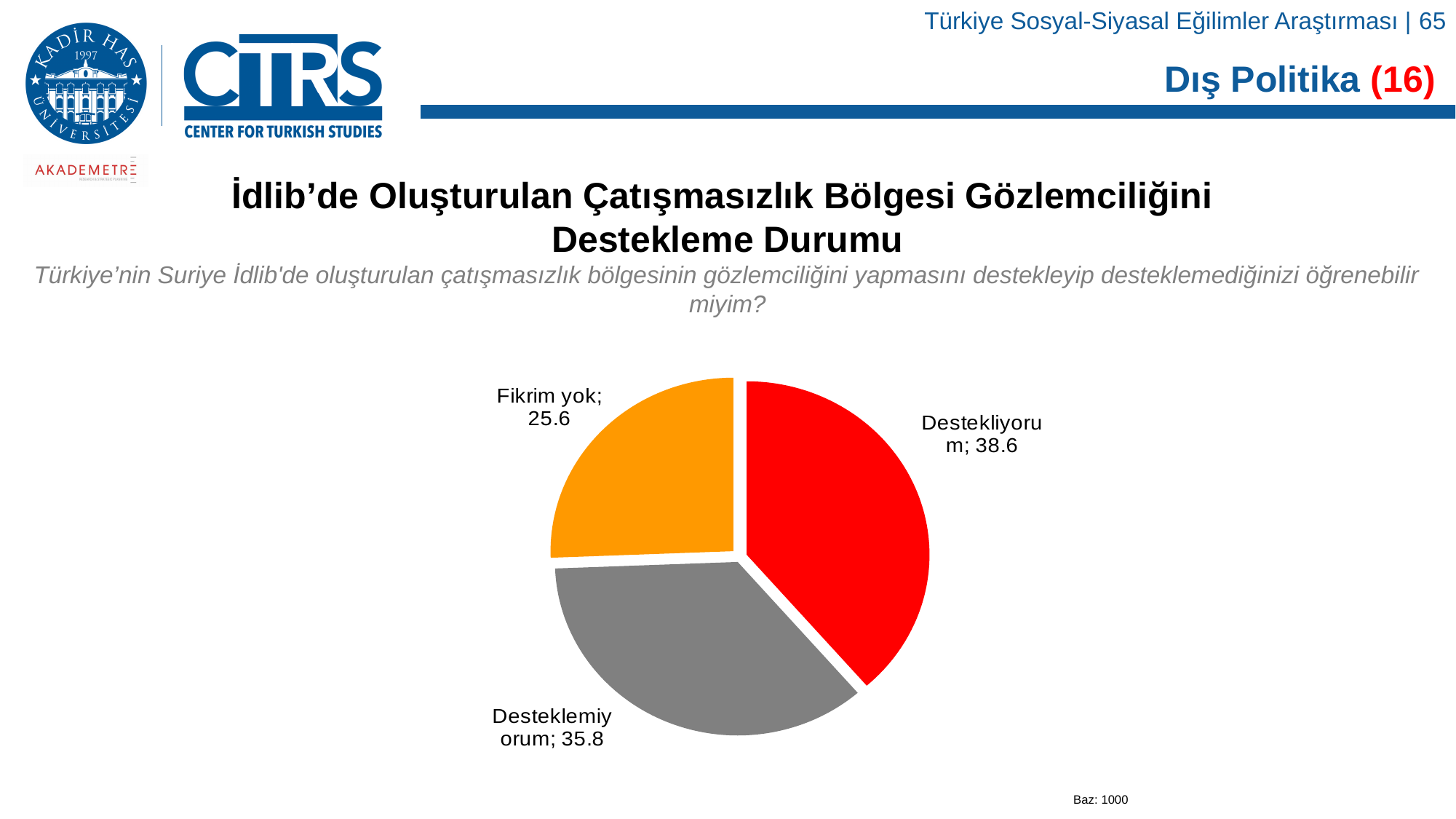
Which is larger, Desteklemiyorum or Fikrim yok? Desteklemiyorum What is the difference between Destekliyorum and Desteklemiyorum? 2.8 What colour is the Fikrim yok slice? orange What is the value for Destekliyorum? 38.6 What is the difference between Desteklemiyorum and Fikrim yok? 10.2 What is the value for Fikrim yok? 25.6 What is the base (Baz) sample size shown on the slide? 1000 Which category has the largest slice? Destekliyorum Which category has the smallest slice? Fikrim yok How many slices does the pie chart have? 3 What is the value for Desteklemiyorum? 35.8 What type of chart is shown on the slide? pie chart